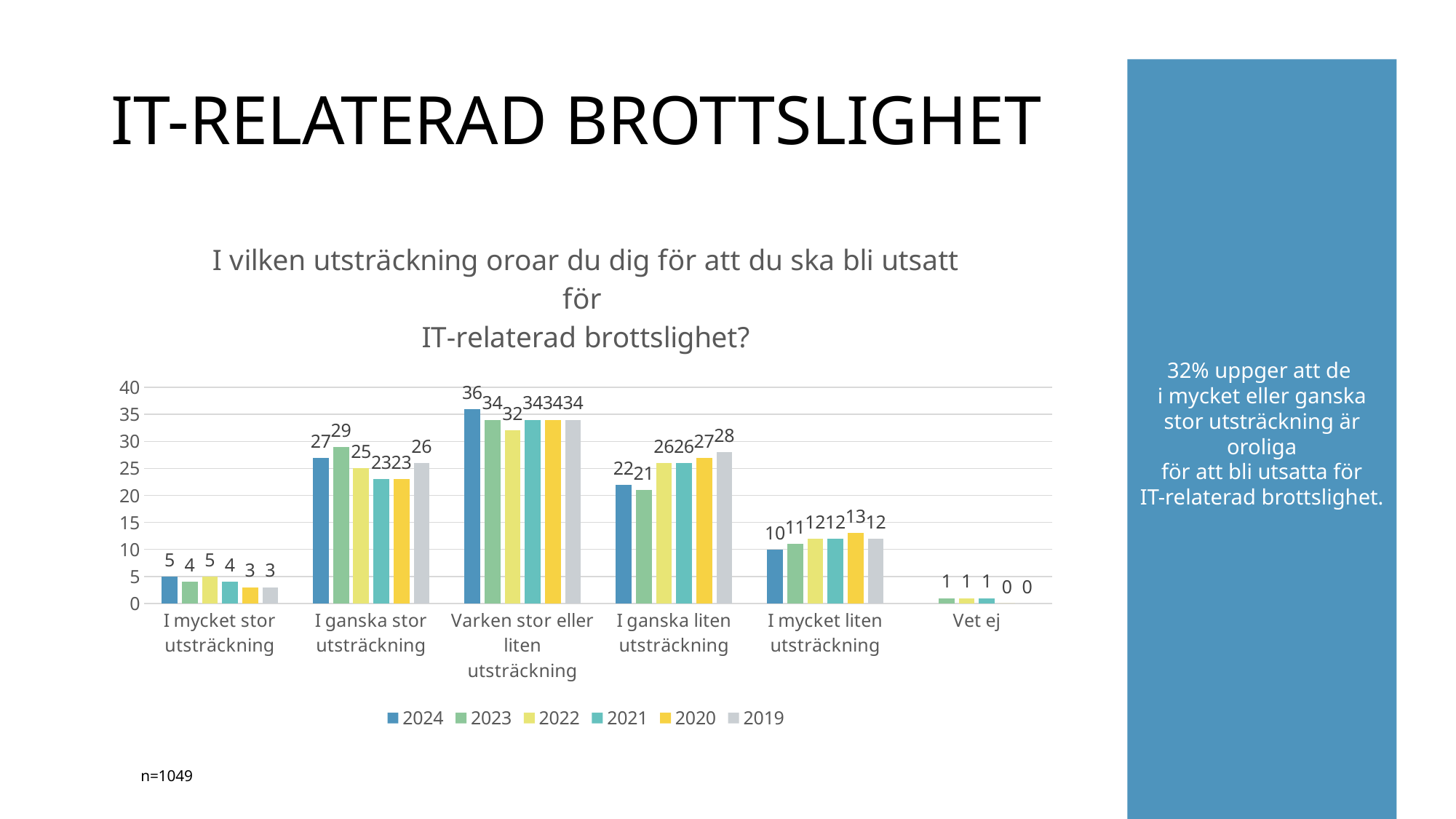
How many categories are shown on the x axis? 6 What is the value for 2023 in the category 'I ganska stor utsträckning'? 29 What is the value for 2024 in the category 'Varken stor eller liten utsträckning'? 36 Which category has the highest value for 2024? Varken stor eller liten utsträckning What is the value for 2020 in the category 'I mycket liten utsträckning'? 13 What is the difference between the 2024 and 2023 values in the category 'I ganska stor utsträckning'? 2 What type of chart is shown on the slide? bar chart How many series does the legend list? 6 In the category 'I ganska liten utsträckning', which is larger: the value for 2024 or the value for 2019? 2019 What is the value for 2019 in the category 'I ganska liten utsträckning'? 28 Which year has the lowest value in the category 'I ganska liten utsträckning'? 2023